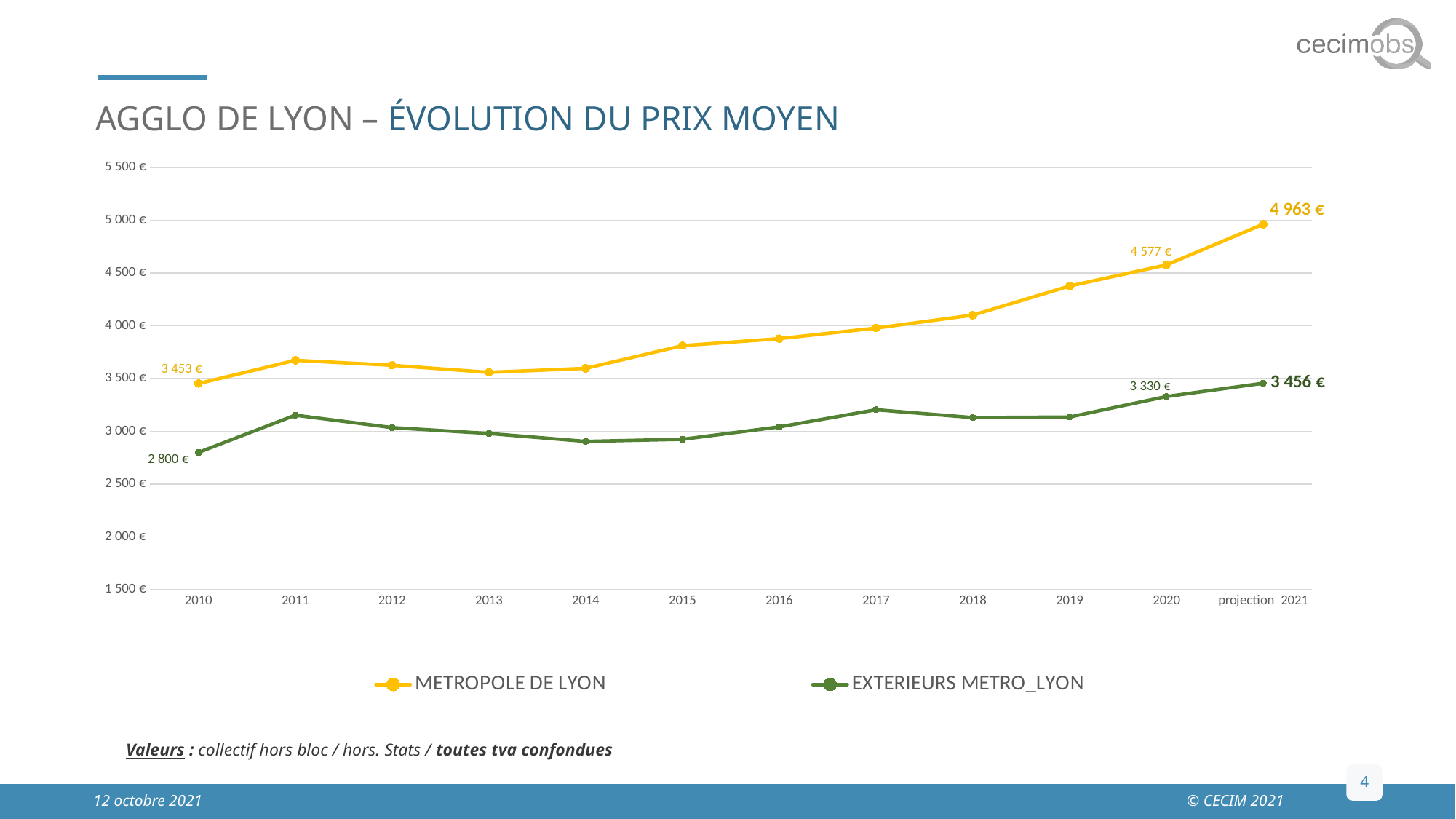
What is the value for EXTERIEURS METRO_LYON for projection 2021? 3 456 € What is the value for METROPOLE DE LYON in 2010? 3 453 € Is the value for METROPOLE DE LYON in 2019 greater or less than 4 000 €? greater What is the value for METROPOLE DE LYON in 2020? 4 577 € What is the difference between the METROPOLE DE LYON value and the EXTERIEURS METRO_LYON value for projection 2021? 1 507 € How many points are plotted along the x axis for each series? 12 Is the value for EXTERIEURS METRO_LYON in 2014 greater or less than 3 000 €? less By how much did the METROPOLE DE LYON value increase between 2010 and 2020? 1 124 € How many series does the legend list? 2 Which series has the higher value in 2020, METROPOLE DE LYON or EXTERIEURS METRO_LYON? METROPOLE DE LYON What is the value for EXTERIEURS METRO_LYON in 2010? 2 800 € What kind of chart is shown on the slide? Line chart